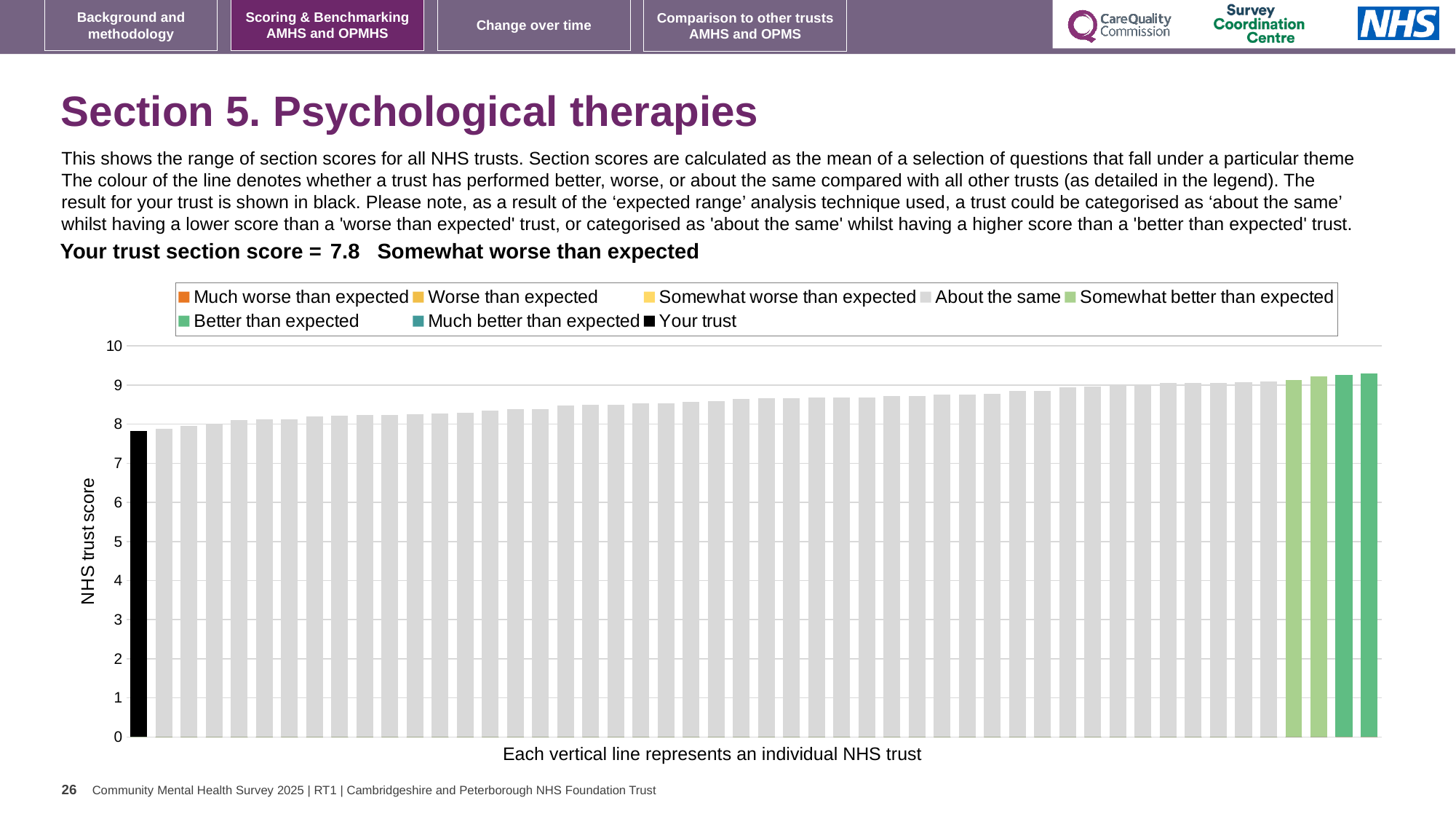
What is the title of the vertical axis? NHS trust score Do the bar values rise or fall moving from left to right along the x axis? Rise What category is your trust's section score placed in, according to the slide? Somewhat worse than expected How many bars on the chart are coloured green? 4 How many entries does the chart legend list? 8 Is the value of the black 'Your trust' bar greater or less than 8? less How many bars on the chart are coloured black? 1 Is the value of the tallest bar on the chart greater or less than 9? greater What is the section score for your trust shown on the slide? 7.8 What does the label under the horizontal axis say? Each vertical line represents an individual NHS trust What kind of chart is shown on the slide? Bar chart